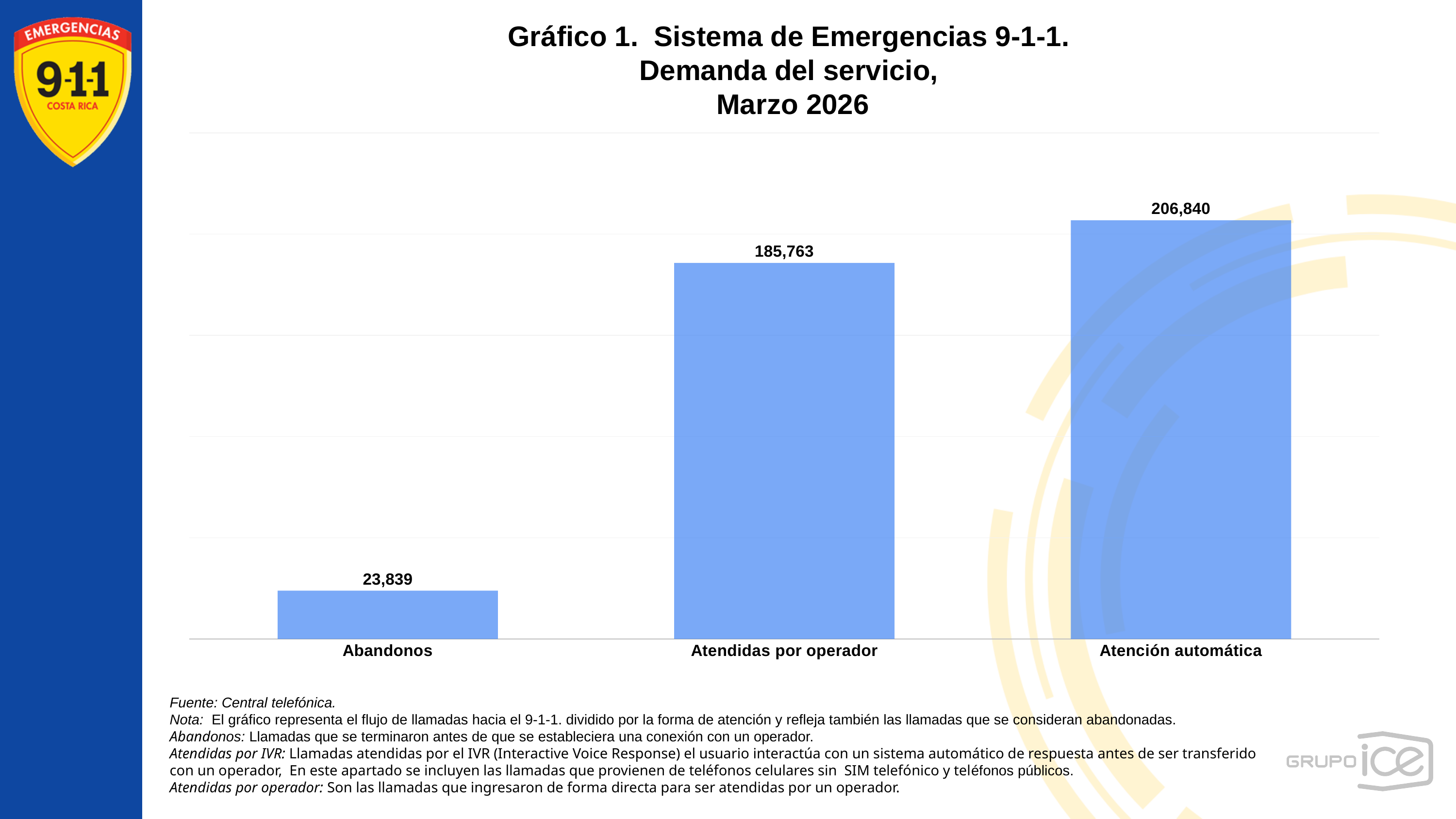
Which is larger, Atendidas por operador or Abandonos? Atendidas por operador What is the value for Abandonos? 23,839 What kind of chart is this? Bar chart What is the value for Atendidas por operador? 185,763 Which category has the lowest value? Abandonos What is the value for Atención automática? 206,840 How many categories are shown in the chart? 3 What month and year does the chart title refer to? Marzo 2026 Which category has the highest value? Atención automática What is the difference between Atendidas por operador and Abandonos? 161,924 What is the difference between Atención automática and Atendidas por operador? 21,077 Do the values rise or fall from left to right across the categories? Rise